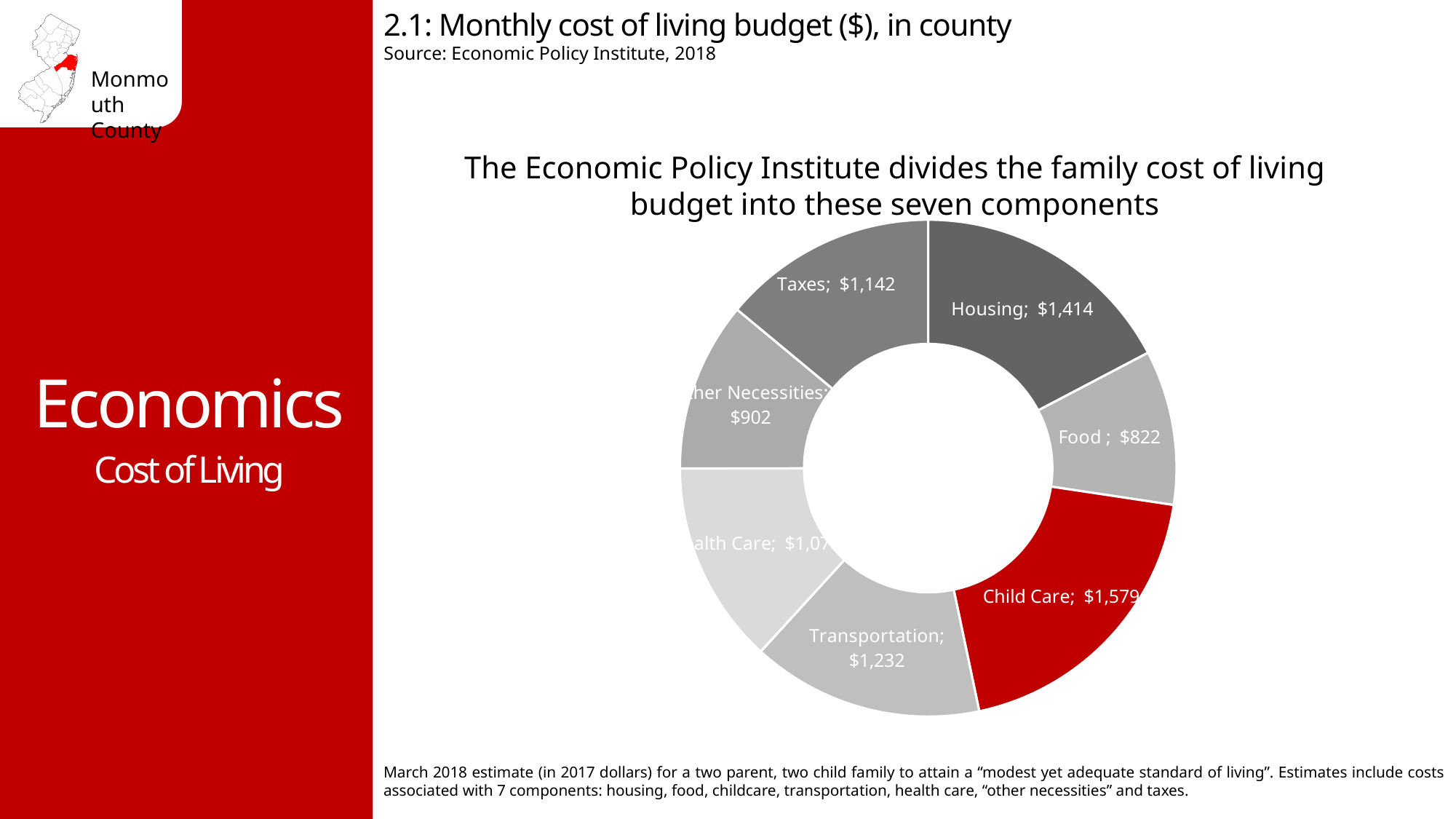
How much more is the monthly cost for Child Care than for Housing? $165 Which is larger, the monthly cost for Transportation or for Taxes? Transportation What is the monthly cost for Housing in the chart? $1,414 How many components does the chart divide the cost of living budget into? 7 What is the monthly cost for Transportation? $1,232 What is the monthly cost for Child Care? $1,579 Which component has the largest monthly cost? Child Care What is the difference between the Transportation and Food monthly costs? $410 What is the monthly cost for Food? $822 Which component has the smallest monthly cost? Food What is the monthly cost for Taxes? $1,142 Which component is shown in red on the chart? Child Care